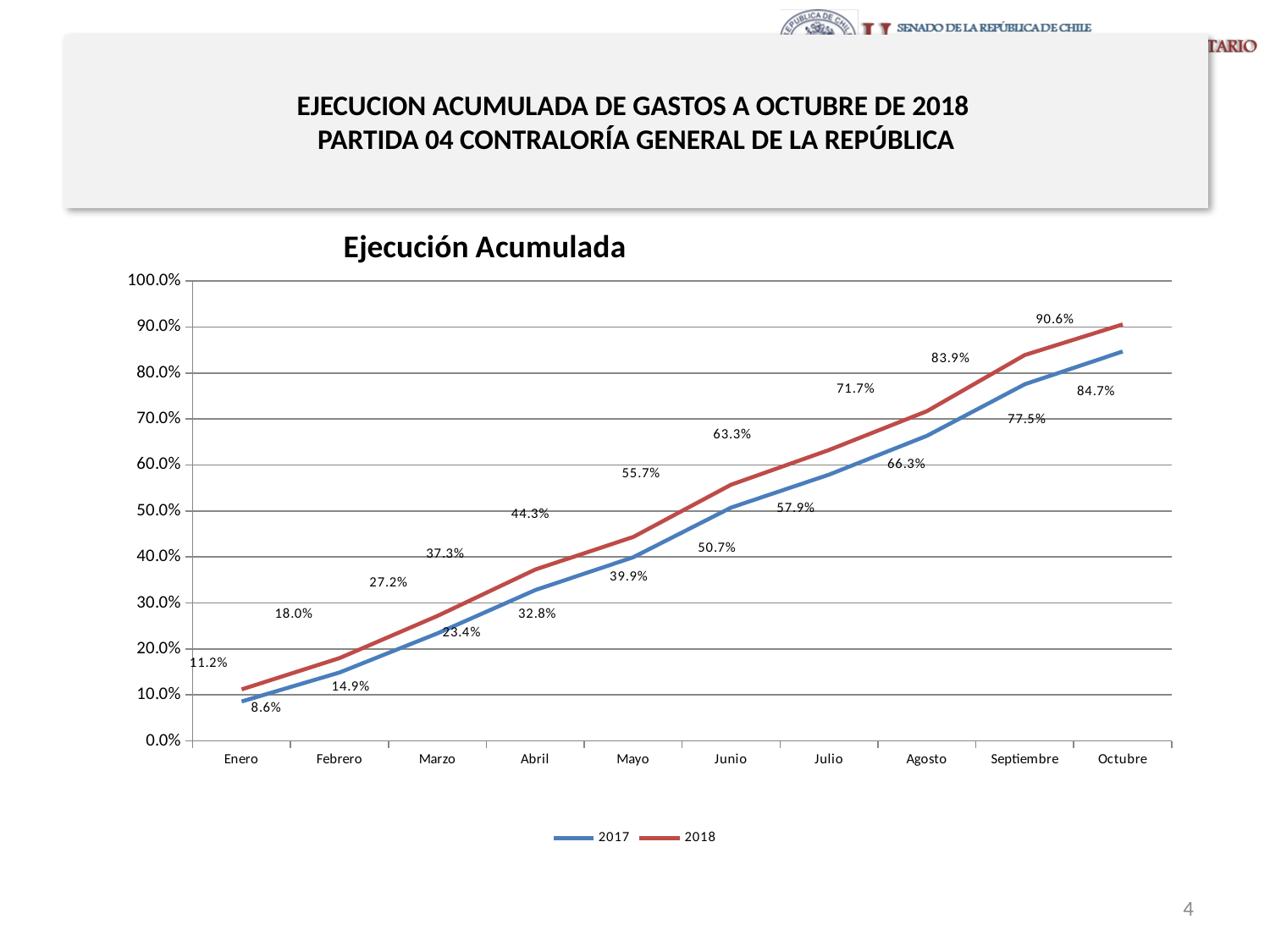
Which series has the higher value in Agosto, 2017 or 2018? 2018 What is the value for 2018 in Junio? 55.7% How many series does the legend list? 2 In which month is the 2017 series lowest? Enero What is the difference between the 2018 and 2017 values in Octubre? 5.9% In which month is the 2018 series highest? Octubre What kind of chart is shown on the slide? line chart Do the values of the 2017 series rise or fall from Enero to Octubre? rise How many months are shown on the x axis? 10 What is the value for 2017 in Enero? 8.6% What is the value for 2018 in Octubre? 90.6% What is the value for 2017 in Septiembre? 77.5%